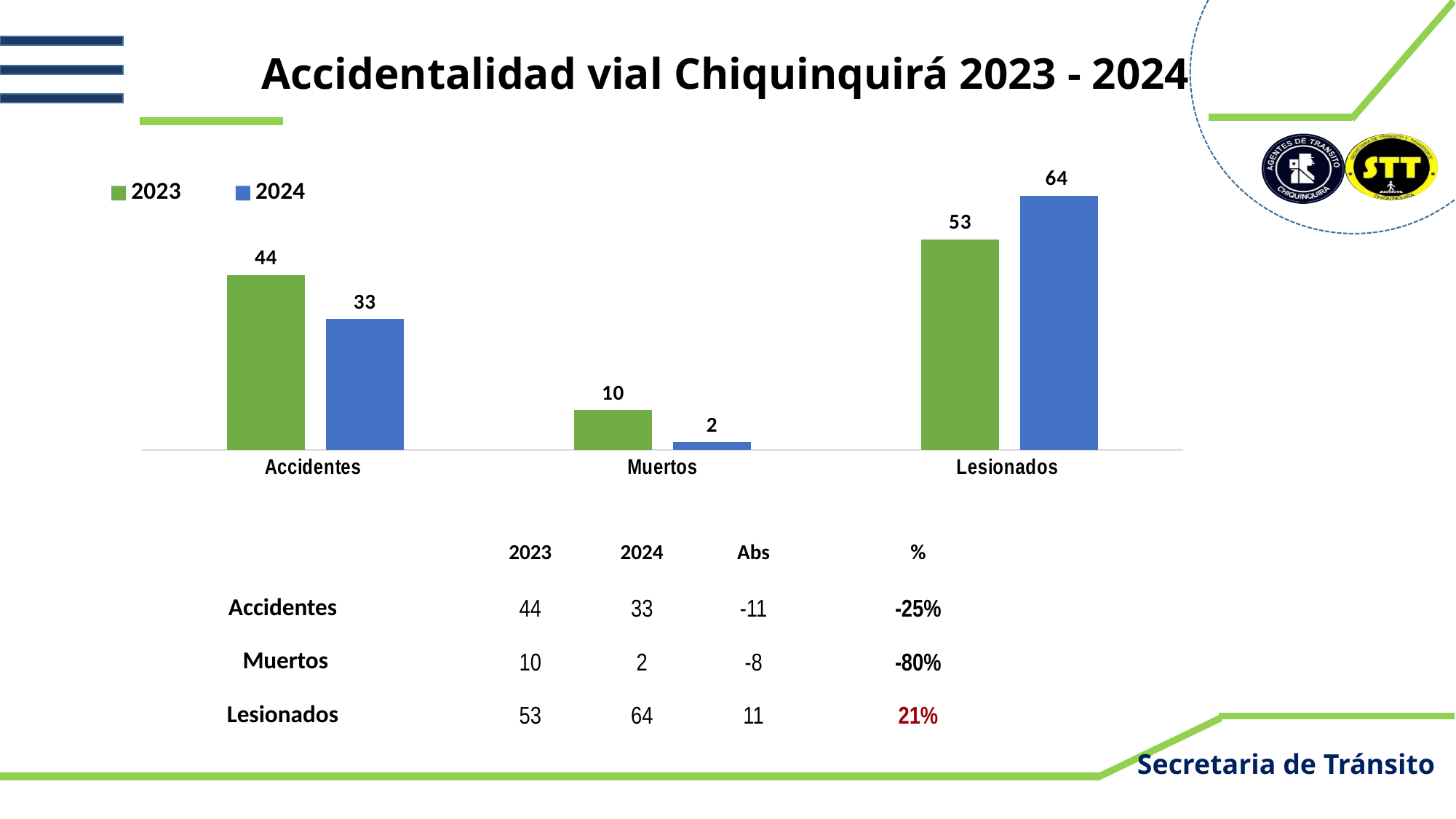
Which is larger for Muertos, the 2023 value or the 2024 value? 2023 Which colour represents the 2024 series? Blue Which category has the lowest value in the 2024 series? Muertos What is the difference between the 2023 and 2024 values for Accidentes? 11 How many series does the legend list? 2 What is the value for Accidentes in the 2023 series? 44 How many categories are shown on the x axis? 3 What is the value for Muertos in the 2024 series? 2 What is the difference between the 2024 and 2023 values for Lesionados? 11 What is the value for Lesionados in the 2024 series? 64 Which category has the highest value in the 2023 series? Lesionados What kind of chart is shown on the slide? Bar chart